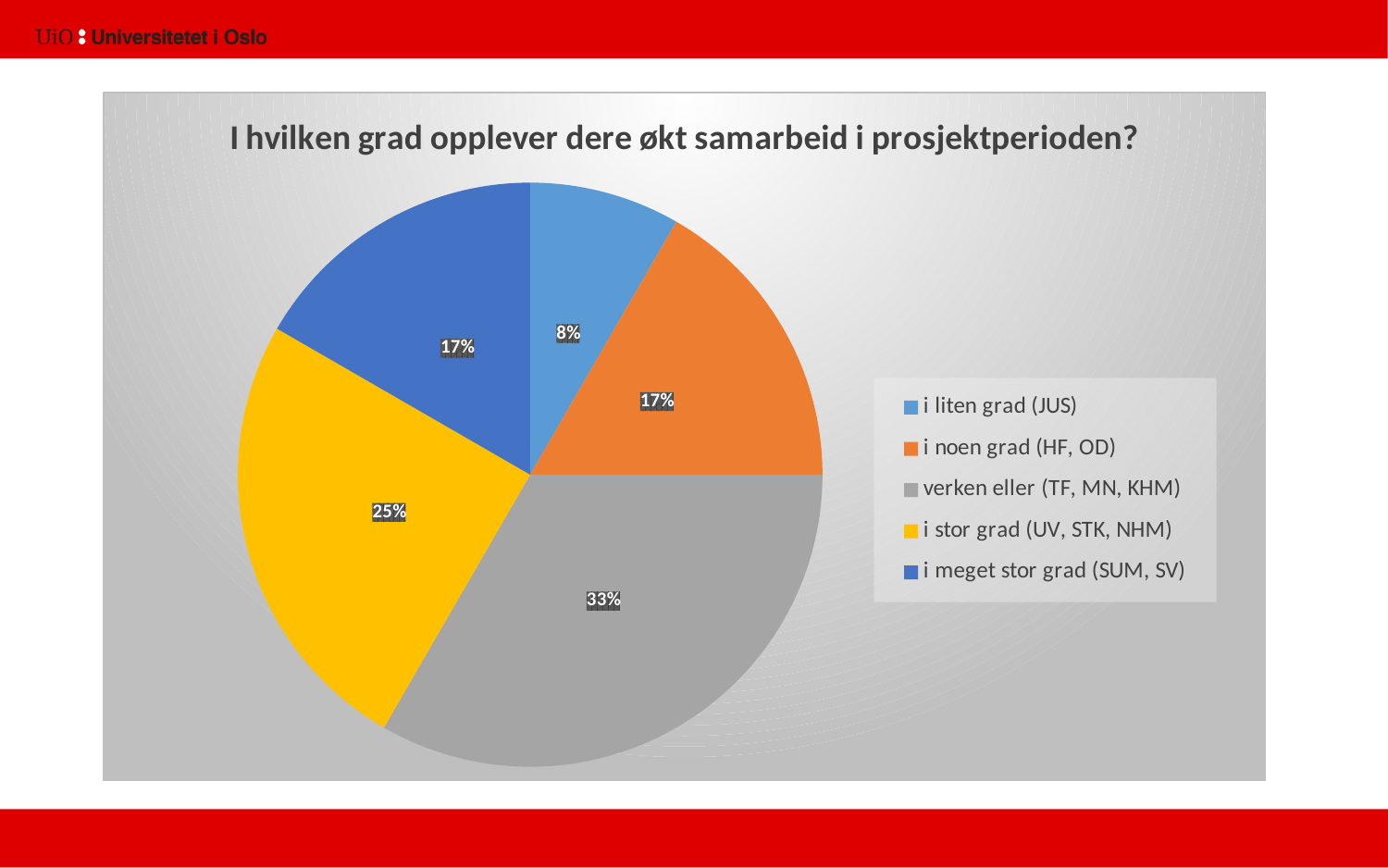
What colour is the slice for 'i stor grad (UV, STK, NHM)'? yellow What share of the pie is labelled for 'verken eller (TF, MN, KHM)'? 33% What is the title of the chart? I hvilken grad opplever dere økt samarbeid i prosjektperioden? Which category has the largest slice of the pie? verken eller (TF, MN, KHM) What is the difference between the shares for 'verken eller (TF, MN, KHM)' and 'i stor grad (UV, STK, NHM)'? 8% How many categories does the legend list? 5 What kind of chart is shown on the slide? pie chart What share of the pie is labelled for 'i stor grad (UV, STK, NHM)'? 25% What share of the pie is labelled for 'i noen grad (HF, OD)'? 17% Which category has the smallest slice of the pie? i liten grad (JUS) Which is larger, the share for 'i stor grad (UV, STK, NHM)' or the share for 'i meget stor grad (SUM, SV)'? i stor grad (UV, STK, NHM)